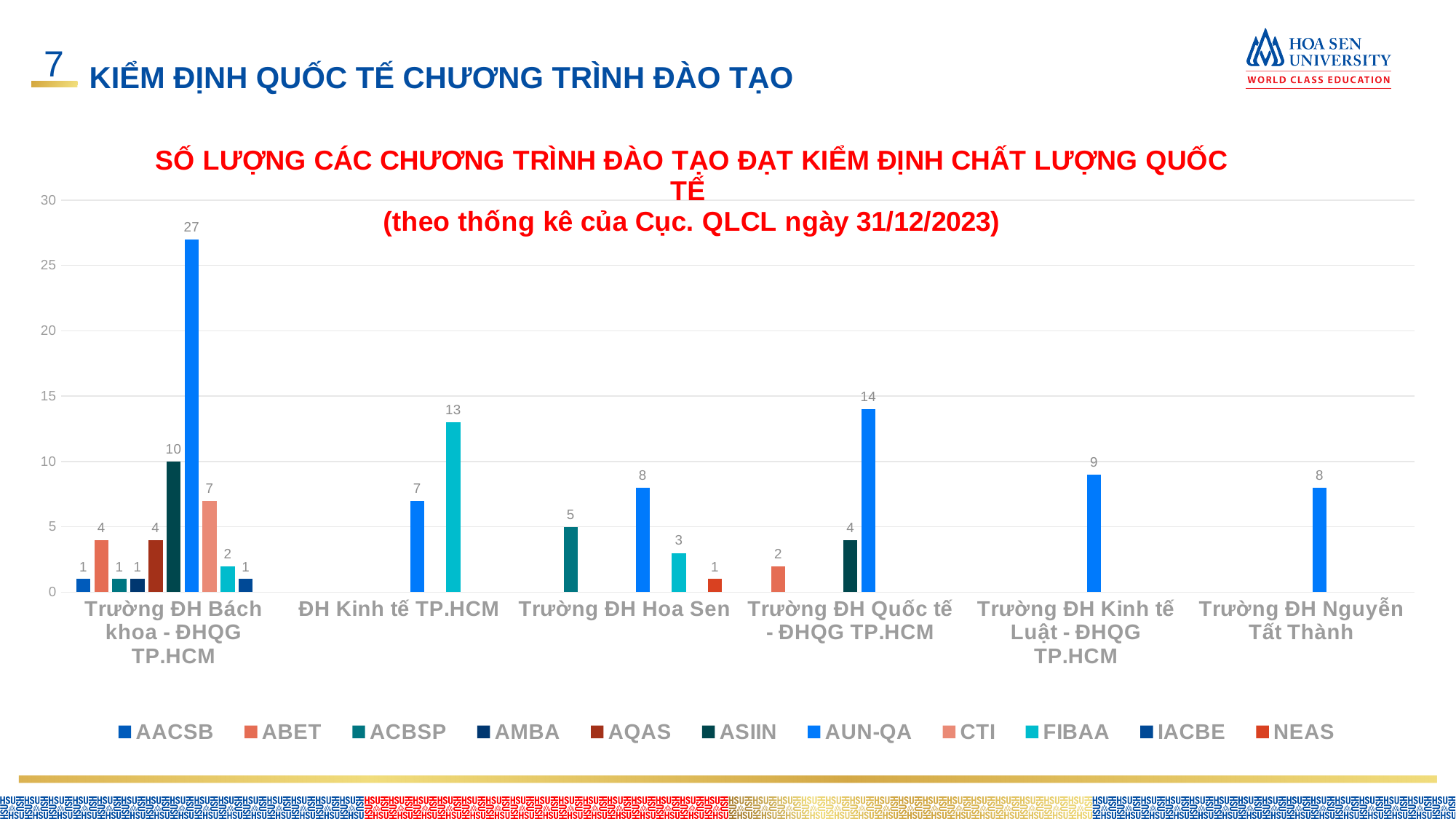
What is the AUN-QA value for Trường ĐH Quốc tế - ĐHQG TP.HCM? 14 What is the difference between the AUN-QA values of Trường ĐH Bách khoa - ĐHQG TP.HCM and Trường ĐH Quốc tế - ĐHQG TP.HCM? 13 What kind of chart is shown on the slide? bar chart What is the ACBSP value for Trường ĐH Hoa Sen? 5 How many universities are shown on the x axis? 6 Is the AUN-QA value for Trường ĐH Bách khoa - ĐHQG TP.HCM greater or less than 25? greater Which university has the highest AUN-QA value? Trường ĐH Bách khoa - ĐHQG TP.HCM How many series does the legend list? 11 Which has a larger AUN-QA value: Trường ĐH Hoa Sen or ĐH Kinh tế TP.HCM? Trường ĐH Hoa Sen What is the AUN-QA value for Trường ĐH Kinh tế Luật - ĐHQG TP.HCM? 9 How many programs accredited by AUN-QA does Trường ĐH Bách khoa - ĐHQG TP.HCM have? 27 What is the FIBAA value for ĐH Kinh tế TP.HCM? 13